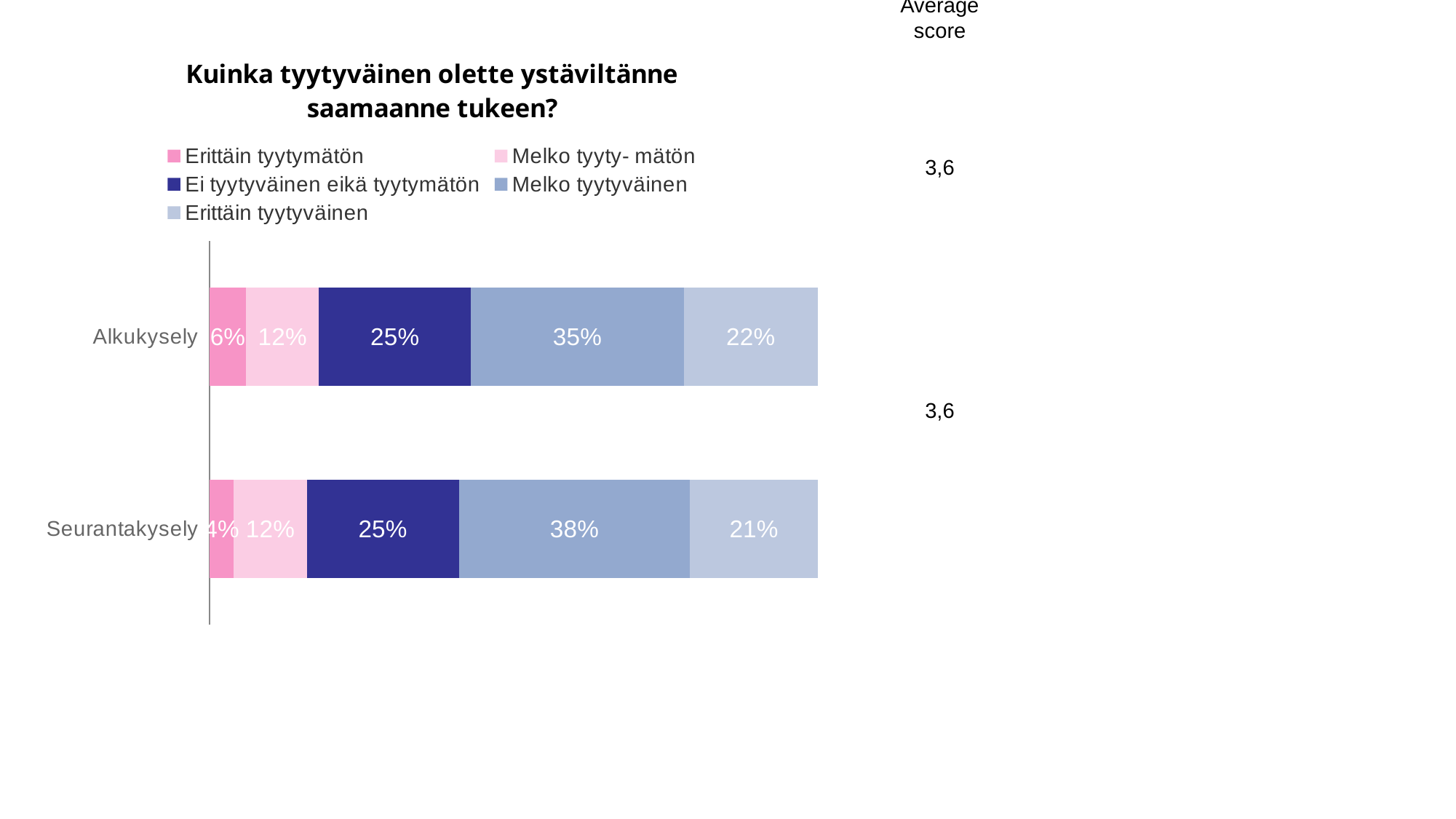
Which bar has the larger Erittäin tyytymätön value, Alkukysely or Seurantakysely? Alkukysely How many series does the legend list? 5 What is the value for Ei tyytyväinen eikä tyytymätön in the Seurantakysely bar? 25% What is the average score shown for Seurantakysely? 3,6 What kind of chart is shown on the slide? Stacked bar chart Which segment is the smallest in the Alkukysely bar? Erittäin tyytymätön How many categories (bars) are plotted in the chart? 2 What is the value for Melko tyytyväinen in the Alkukysely bar? 35% What is the value for Erittäin tyytymätön in the Seurantakysely bar? 4% Which segment is the largest in the Seurantakysely bar? Melko tyytyväinen What is the value for Erittäin tyytyväinen in the Alkukysely bar? 22% What is the difference between the Melko tyytyväinen values for Seurantakysely and Alkukysely? 3%